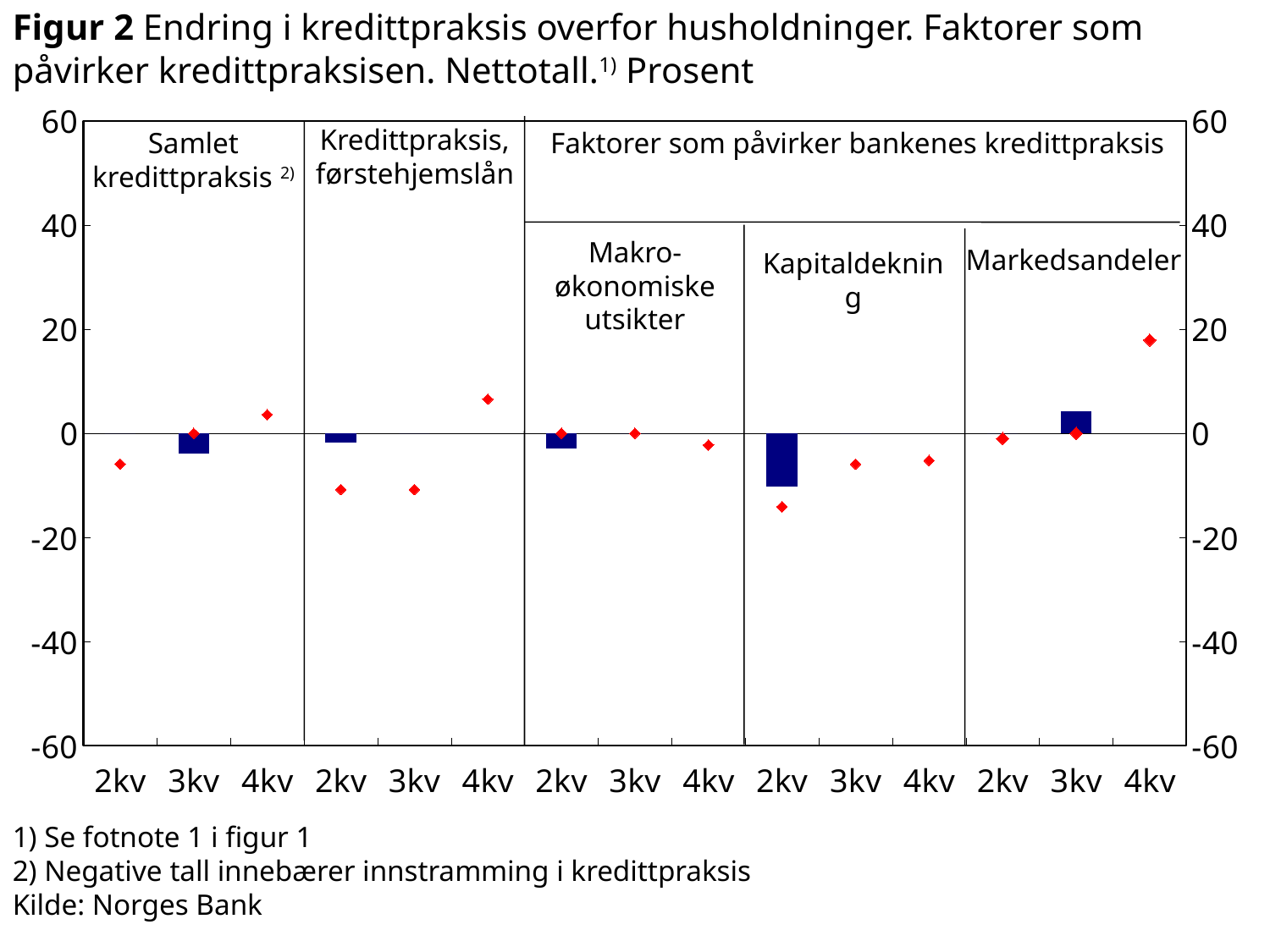
Which is larger, the red diamond for 4kv in the Markedsandeler panel or the red diamond for 4kv in the Kredittpraksis, førstehjemslån panel? Markedsandeler, 4kv Is the red diamond for 4kv in the Markedsandeler panel greater or less than 0? greater Is the blue bar for 2kv in the Kapitaldekning panel greater or less than -20? greater In which panel and quarter is the highest red diamond marker found? Markedsandeler, 4kv In which panel and quarter is the lowest red diamond marker found? Kapitaldekning, 2kv How many quarter labels (categories) are shown along the x axis in total? 15 Which panel contains the lowest (most negative) blue bar? Kapitaldekning Is the red diamond for 2kv in the Kapitaldekning panel greater or less than -10? less How many panels (sections) is the chart divided into? 5 What kind of chart is shown on the slide? combination chart with bars and diamond markers Which panel contains the only blue bar that is positive? Markedsandeler What is the source given for the chart? Norges Bank